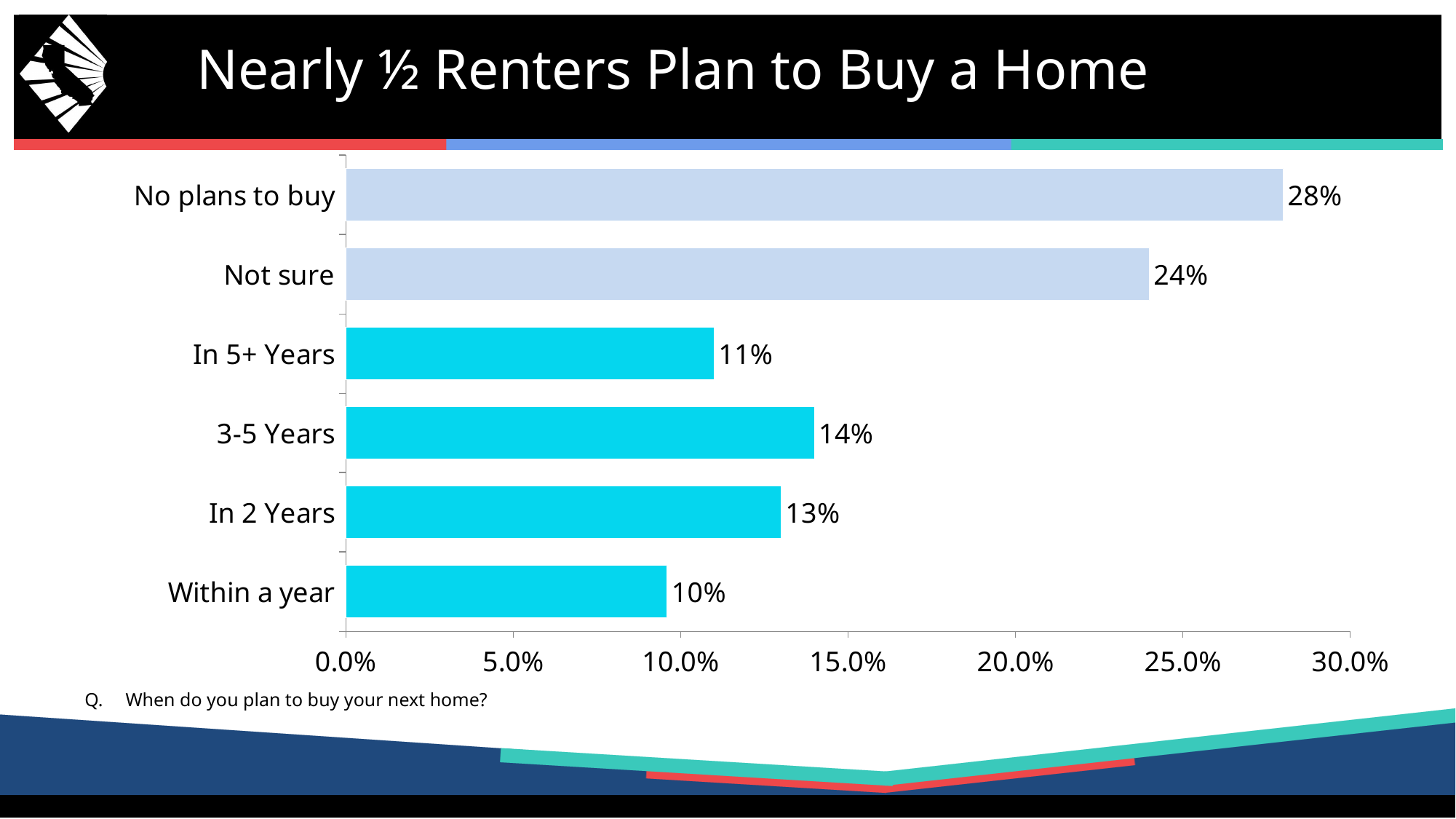
How many categories are shown in the chart? 6 What percentage of renters plan to buy within a year? 10% Which is larger, the value for 'In 2 Years' or the value for 'In 5+ Years'? In 2 Years What is the difference between the 'No plans to buy' and 'Not sure' values? 4% Which category has the highest value? No plans to buy What percentage of renters have no plans to buy? 28% What percentage of renters are not sure when they will buy? 24% What percentage of renters plan to buy in 3-5 years? 14% Is the value for 'Not sure' greater or less than 20.0%? greater What is the title of the slide? Nearly ½ Renters Plan to Buy a Home What kind of chart is shown on the slide? Bar chart Which category has the lowest value? Within a year